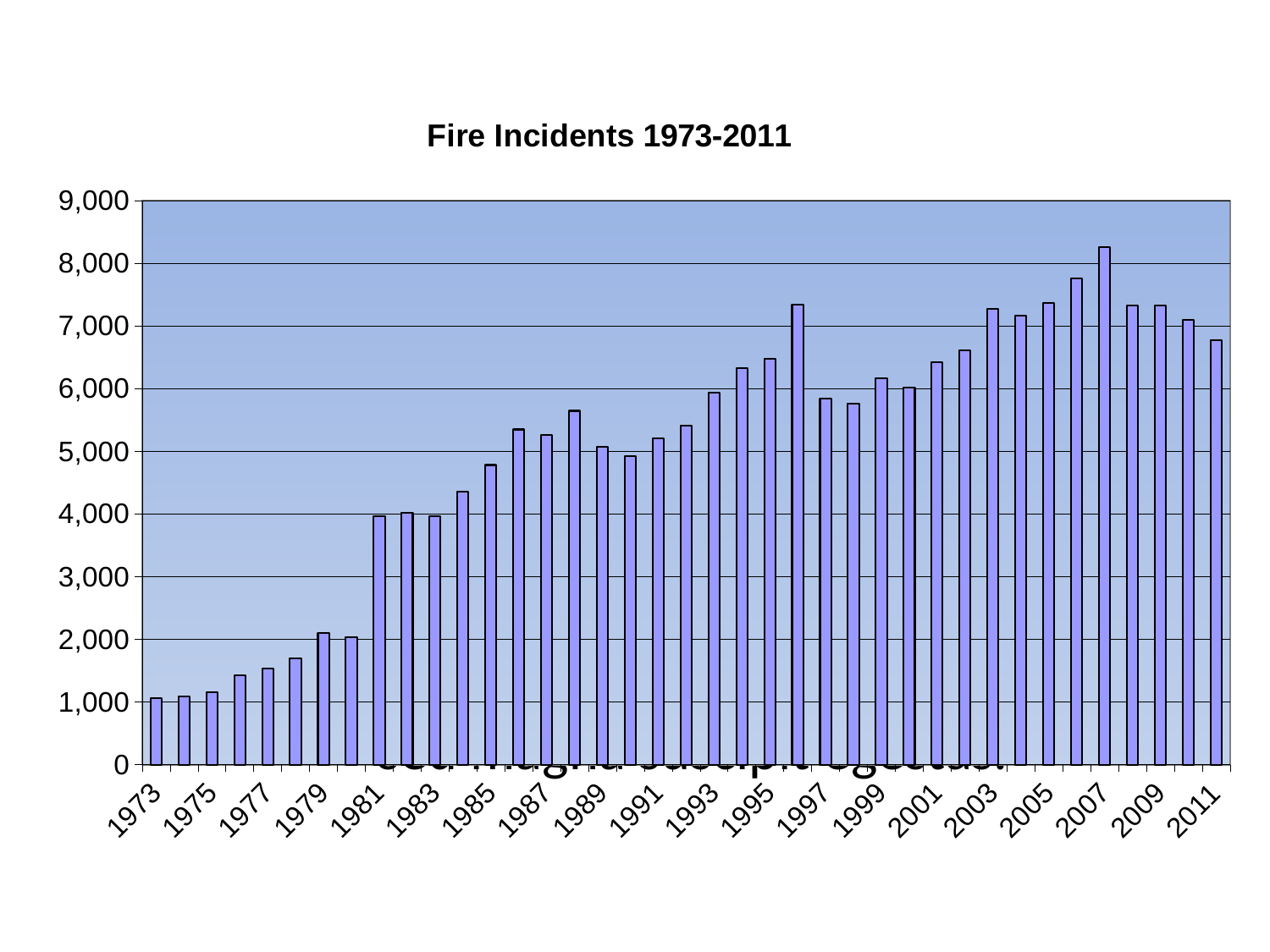
Which year has more fire incidents, 1996 or 1997? 1996 Is the value for 1973 greater or less than 2,000? less Which year has more fire incidents, 1973 or 2007? 2007 Is the value for 2007 greater or less than 8,000? greater Is the value for 1996 greater or less than 7,000? greater What is the title of the chart? Fire Incidents 1973-2011 What kind of chart is shown on the slide? Bar chart Do the values generally rise or fall from 1973 to 2011? Rise Which year has the highest number of fire incidents? 2007 How many years (bars) are plotted on the chart? 39